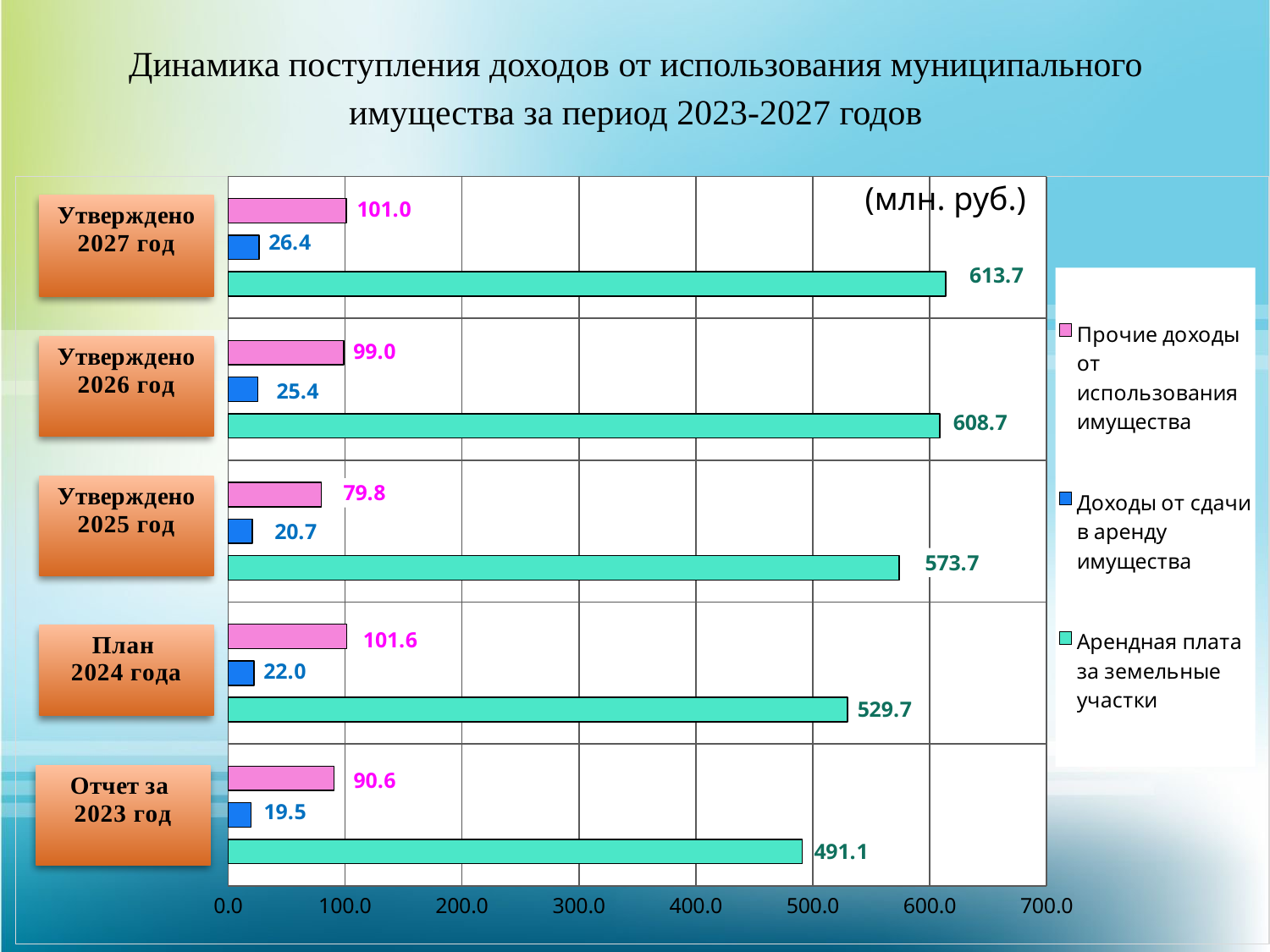
How many series does the legend list? 3 What is the value of Прочие доходы от использования имущества for План 2024 года? 101.6 Which category has the lowest value for Доходы от сдачи в аренду имущества? Отчет за 2023 год What is the value of Доходы от сдачи в аренду имущества for Отчет за 2023 год? 19.5 Which is larger: Прочие доходы от использования имущества for План 2024 года or for Утверждено 2027 год? План 2024 года What is the value of Арендная плата за земельные участки for Утверждено 2027 год? 613.7 What unit of measurement is indicated on the chart? млн. руб. Does Арендная плата за земельные участки rise or fall from Отчет за 2023 год to Утверждено 2027 год? Rise Which category has the highest value for Арендная плата за земельные участки? Утверждено 2027 год How many categories (periods) are shown on the chart? 5 What is the difference between Арендная плата за земельные участки for Утверждено 2027 год and for Отчет за 2023 год? 122.6 What kind of chart is shown on the slide? Bar chart